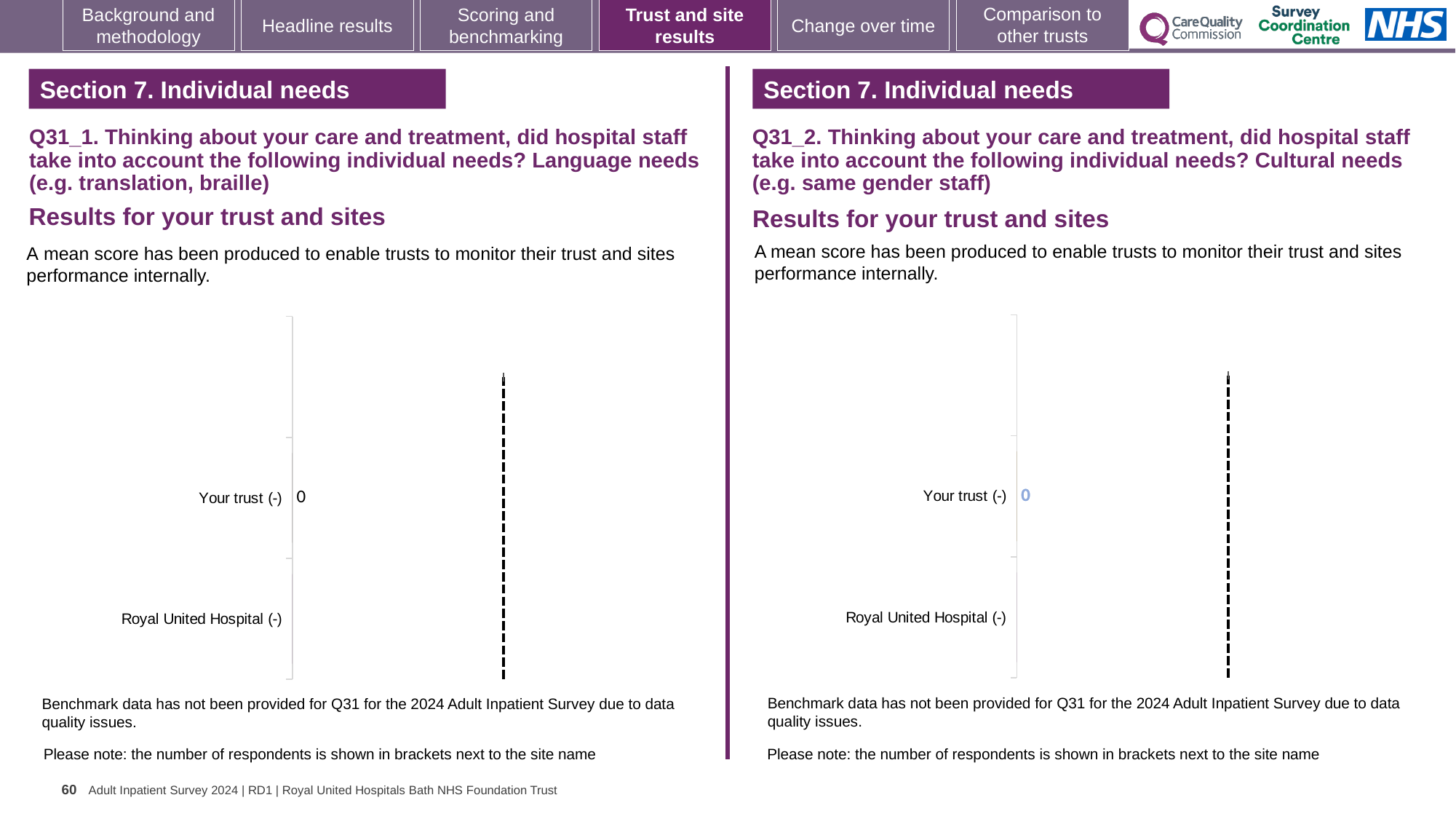
On the right chart (Q31_2, Cultural needs), what value is shown for Your trust? 0 On the left chart (Q31_1, Language needs), what value is shown for Your trust? 0 On the left chart (Q31_1, Language needs), how many categories are listed on the axis? 2 On the right chart (Q31_2, Cultural needs), how many categories are listed on the axis? 2 On the right chart (Q31_2, Cultural needs), what is the label of the first category on the axis? Your trust (-) On the left chart (Q31_1, Language needs), what is the label of the second category on the axis? Royal United Hospital (-) What kind of chart is the right chart (Q31_2, Cultural needs)? Bar chart What kind of chart is the left chart (Q31_1, Language needs)? Bar chart